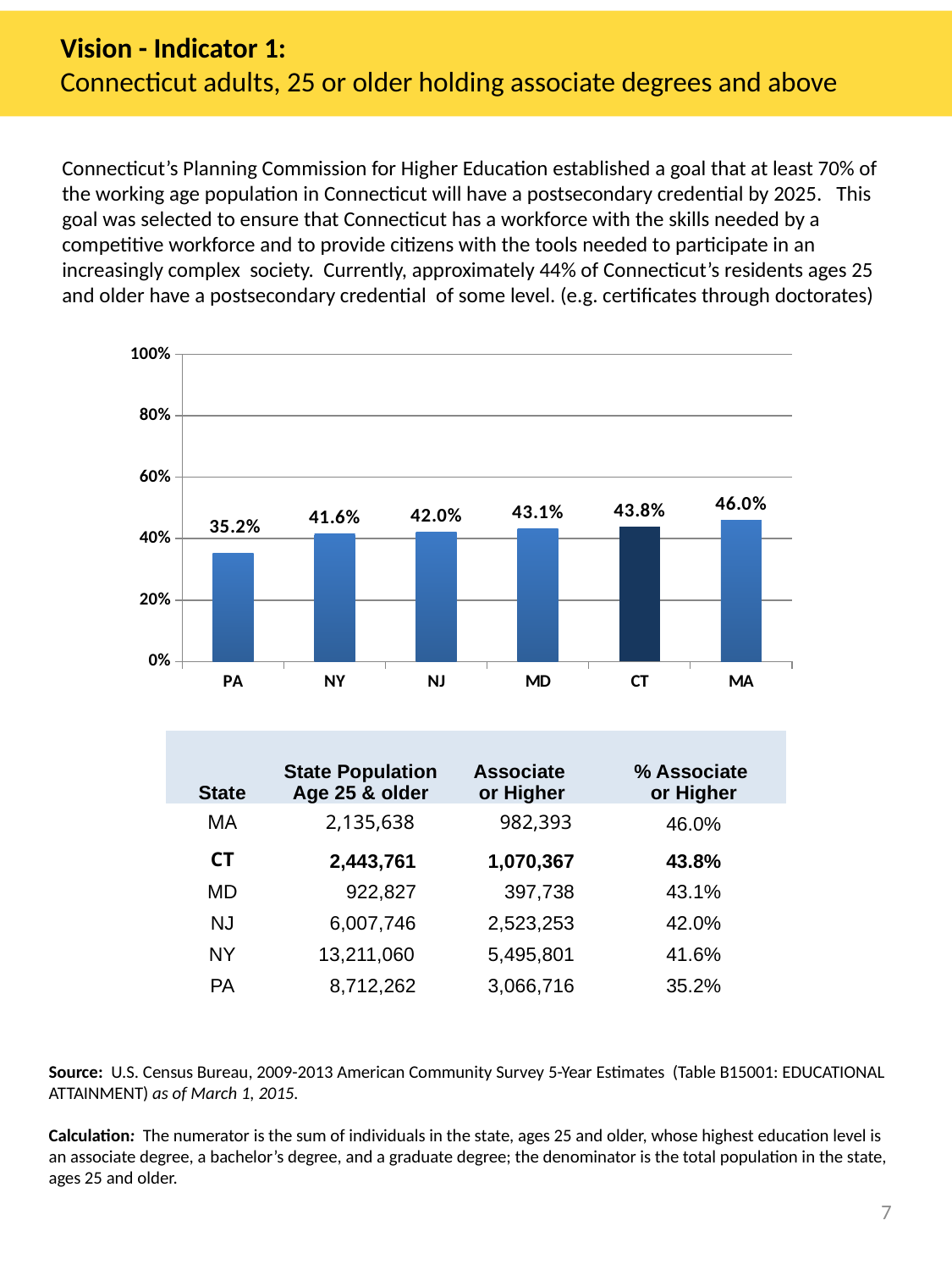
What kind of chart is shown on the slide? bar chart What is the value for PA in the bar chart? 35.2% Do the values in the bar chart rise or fall from PA to MA along the x axis? rise How many states are shown in the bar chart? 6 What is the difference between the values for MA and CT in the bar chart? 2.2% Is the value for MA in the bar chart greater or less than 60%? less What is the difference between the values for NY and PA in the bar chart? 6.4% What is the value for NJ in the bar chart? 42.0% Which state has the lowest value in the bar chart? PA Which is larger in the bar chart, the value for MD or the value for NJ? MD Which state has the highest value in the bar chart? MA What is the value for CT in the bar chart? 43.8%